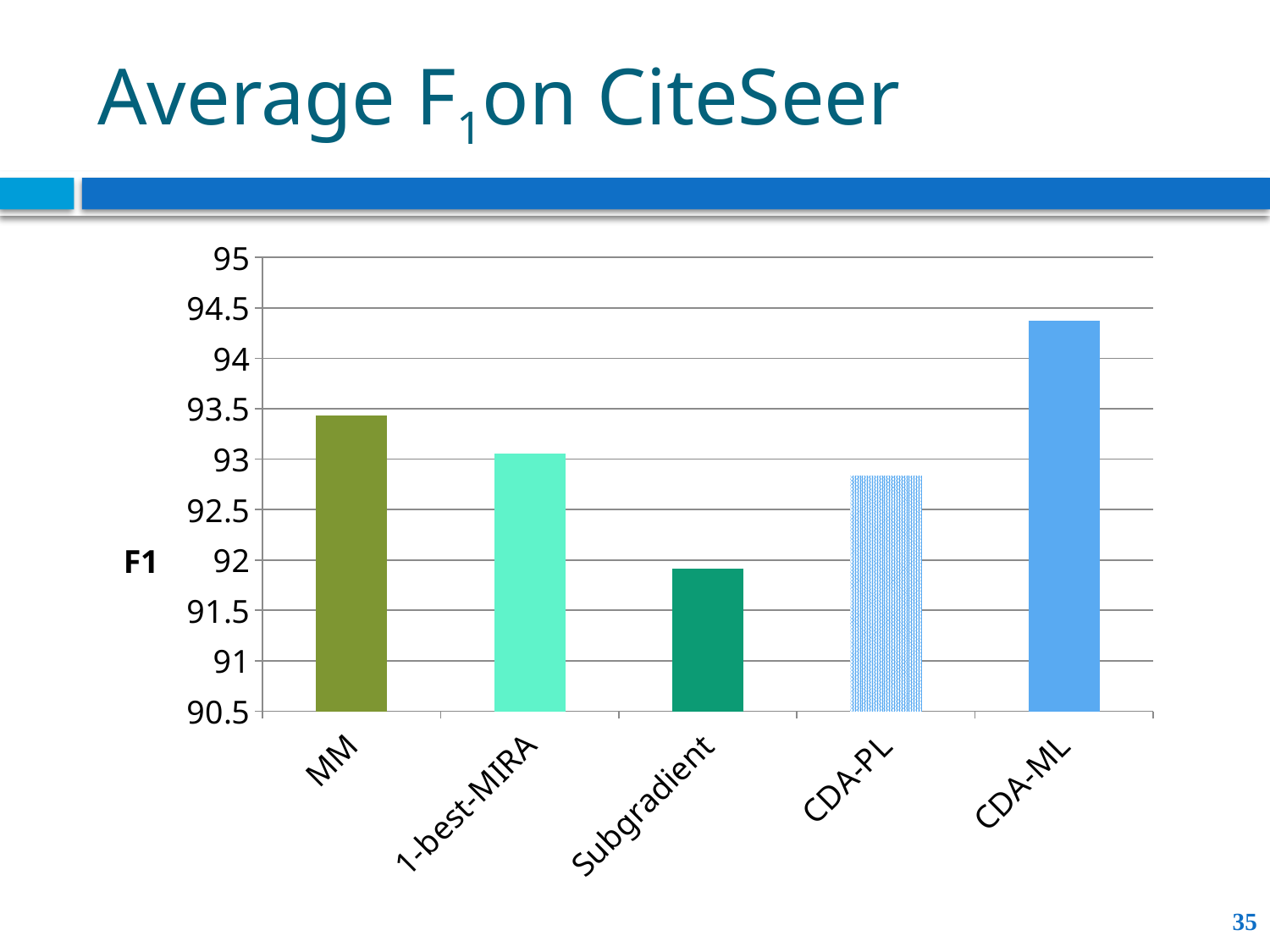
How many methods are compared in the chart? 5 Is the F1 value for Subgradient greater or less than 92.5? less Is the F1 value for CDA-ML greater or less than 94? greater Which method has the highest F1 value in the chart? CDA-ML Which has a higher F1 value, Subgradient or CDA-PL? CDA-PL Is the F1 value for MM greater or less than 93? greater Which has a higher F1 value, CDA-ML or MM? CDA-ML Which method has the lowest F1 value in the chart? Subgradient What kind of chart is shown on the slide? bar chart What is the label on the vertical axis of the chart? F1 Which has a higher F1 value, MM or 1-best-MIRA? MM